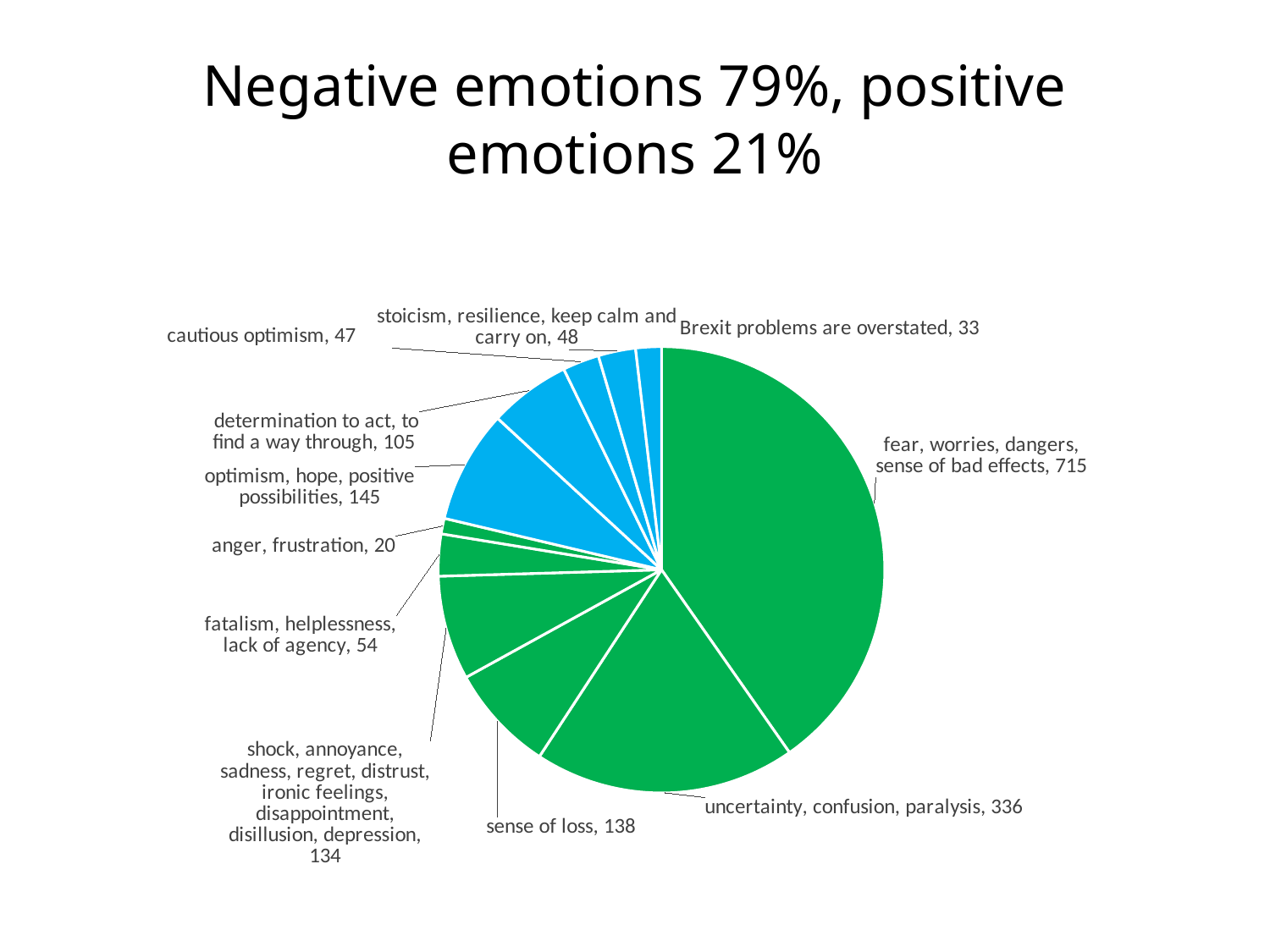
Which has the larger value: 'sense of loss' or 'fatalism, helplessness, lack of agency'? sense of loss What value is shown for the 'uncertainty, confusion, paralysis' slice? 336 What value is shown for the 'optimism, hope, positive possibilities' slice? 145 What is the difference between the values for 'optimism, hope, positive possibilities' and 'determination to act, to find a way through'? 40 What is the difference between the values for 'fear, worries, dangers, sense of bad effects' and 'uncertainty, confusion, paralysis'? 379 Which slice of the pie has the largest value? fear, worries, dangers, sense of bad effects What is the title of the slide? Negative emotions 79%, positive emotions 21% Which slice of the pie has the smallest value? anger, frustration What kind of chart is shown on the slide? pie chart How many slices does the pie chart have? 11 Which has the larger value: 'cautious optimism' or 'stoicism, resilience, keep calm and carry on'? stoicism, resilience, keep calm and carry on What value is shown for the 'Brexit problems are overstated' slice? 33